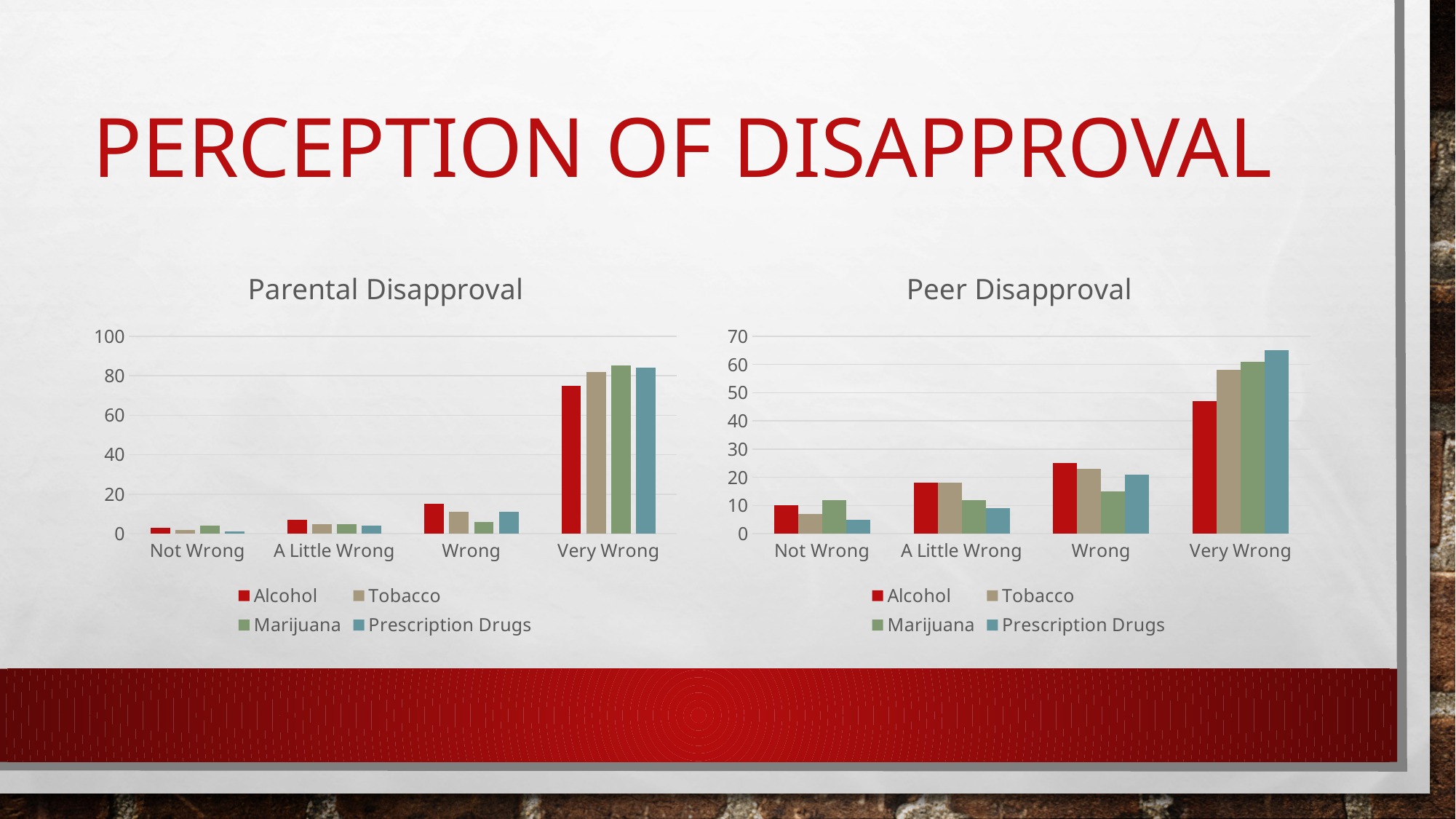
What kind of chart is the Parental Disapproval chart? bar chart In the Parental Disapproval chart, which series has the lowest value in the Wrong category? Marijuana In the Parental Disapproval chart, is the value for Marijuana in the Very Wrong category greater or less than 80? greater In the Peer Disapproval chart, which series has the lowest value in the Very Wrong category? Alcohol In the Peer Disapproval chart, is the value for Alcohol in the Very Wrong category greater or less than 50? less What is the title of the chart on the left side of the slide? Parental Disapproval In the Peer Disapproval chart, do the Alcohol values rise or fall from Not Wrong to Very Wrong? rise How many series does the legend of the Peer Disapproval chart list? 4 In the Parental Disapproval chart, is the value for Alcohol in the Very Wrong category greater or less than 80? less In the Peer Disapproval chart, which is larger in the Not Wrong category: Marijuana or Prescription Drugs? Marijuana How many categories are shown on the x axis of the Parental Disapproval chart? 4 In the Peer Disapproval chart, which series has the highest value in the Very Wrong category? Prescription Drugs